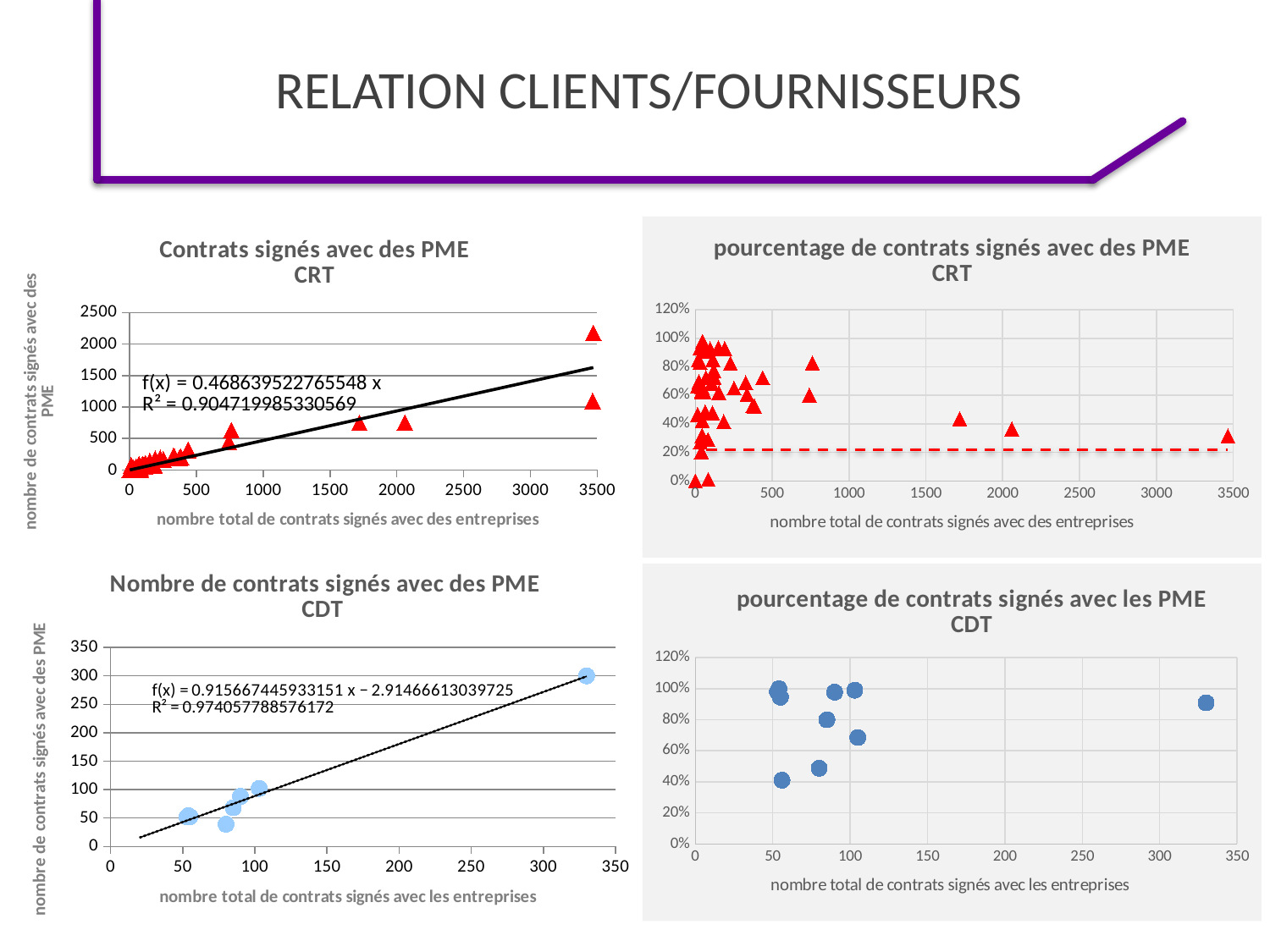
In the bottom-right chart 'pourcentage de contrats signés avec les PME CDT', is the point plotted near x = 330 greater or less than 80%? greater In the bottom-left chart 'Nombre de contrats signés avec des PME CDT', what R² value is printed for the trendline? R² = 0.974057788576172 In the top-left chart 'Contrats signés avec des PME CRT', is the highest plotted point greater or less than 2000? greater In the bottom-left chart 'Nombre de contrats signés avec des PME CDT', do the values rise or fall as the x-axis value increases? rise How many points are plotted in the bottom-right chart 'pourcentage de contrats signés avec les PME CDT'? 10 In the top-left chart 'Contrats signés avec des PME CRT', is the point plotted near x = 1700 greater or less than 1000 on the y axis? less What kind of chart is the top-left chart titled 'Contrats signés avec des PME CRT'? scatter chart In the top-left chart 'Contrats signés avec des PME CRT', what R² value is printed for the trendline? R² = 0.904719985330569 What kind of chart is the bottom-right chart 'pourcentage de contrats signés avec les PME CDT'? scatter chart In the top-right chart 'pourcentage de contrats signés avec des PME CRT', do the percentages generally rise or fall as the number of contracts increases along the x axis? fall